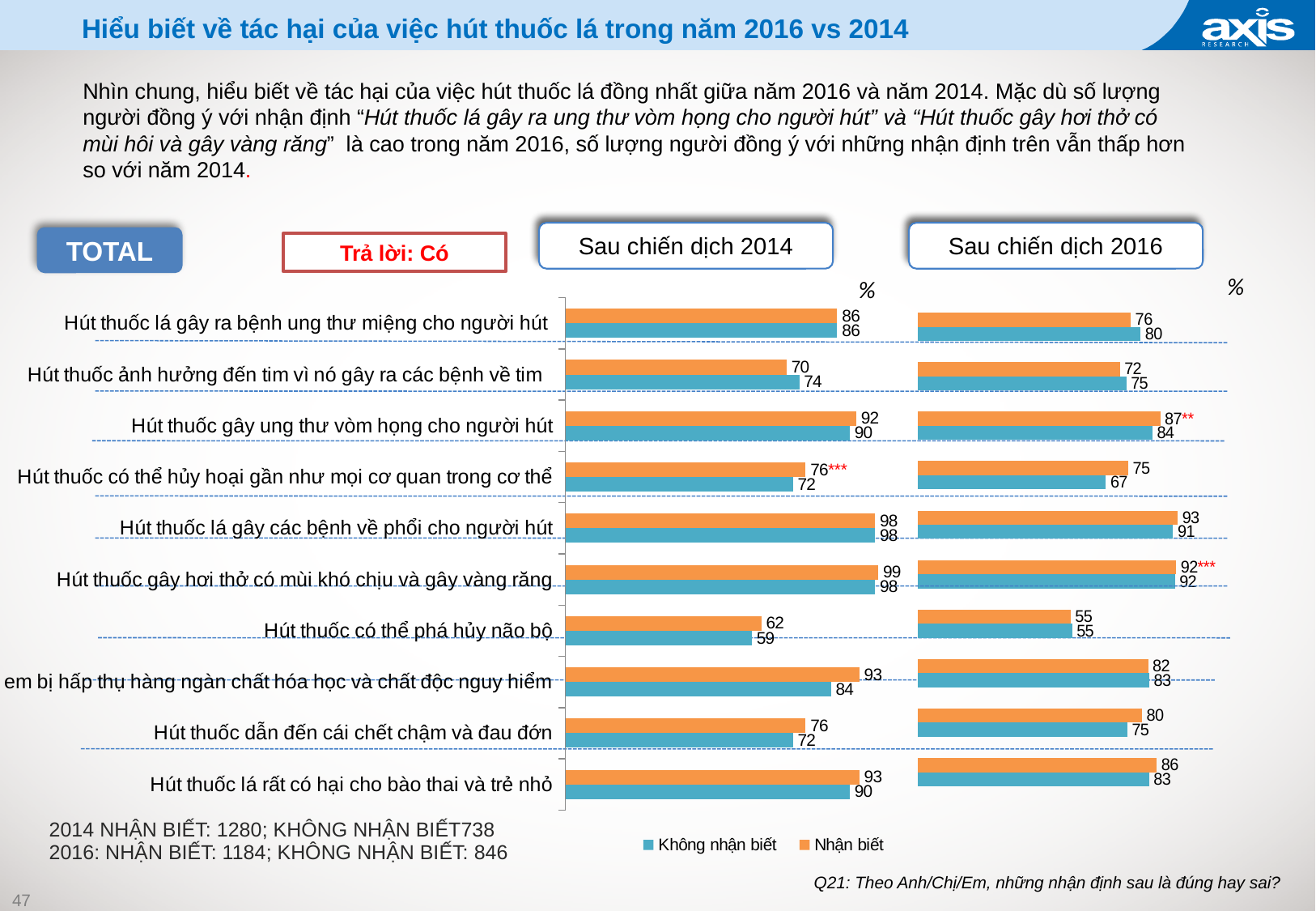
In the 'Sau chiến dịch 2014' chart, which category has the highest 'Nhận biết' value? Hút thuốc gây hơi thở có mùi khó chịu và gây vàng răng In the 'Sau chiến dịch 2016' chart, what is the difference between the 'Nhận biết' and 'Không nhận biết' values for 'Hút thuốc dẫn đến cái chết chậm và đau đớn'? 5 What type of chart is used for 'Sau chiến dịch 2016'? Bar chart In the 'Sau chiến dịch 2016' chart, what is the 'Nhận biết' value for 'Hút thuốc lá gây ra bệnh ung thư miệng cho người hút'? 76 In the 'Sau chiến dịch 2014' chart, what is the difference between the 'Nhận biết' and 'Không nhận biết' values for 'em bị hấp thụ hàng ngàn chất hóa học và chất độc nguy hiểm'? 9 In the 'Sau chiến dịch 2014' chart, which category has the lowest 'Nhận biết' value? Hút thuốc có thể phá hủy não bộ In the 'Sau chiến dịch 2016' chart, which is larger for 'Hút thuốc lá gây ra bệnh ung thư miệng cho người hút': 'Nhận biết' or 'Không nhận biết'? Không nhận biết How many series does the legend list? 2 How many categories are shown in the 'Sau chiến dịch 2014' chart? 10 In the 'Sau chiến dịch 2014' chart, what is the 'Nhận biết' value for 'Hút thuốc gây ung thư vòm họng cho người hút'? 92 In the 'Sau chiến dịch 2016' chart, what is the 'Không nhận biết' value for 'Hút thuốc có thể hủy hoại gần như mọi cơ quan trong cơ thể'? 67 In the 'Sau chiến dịch 2016' chart, which category has the lowest 'Không nhận biết' value? Hút thuốc có thể phá hủy não bộ